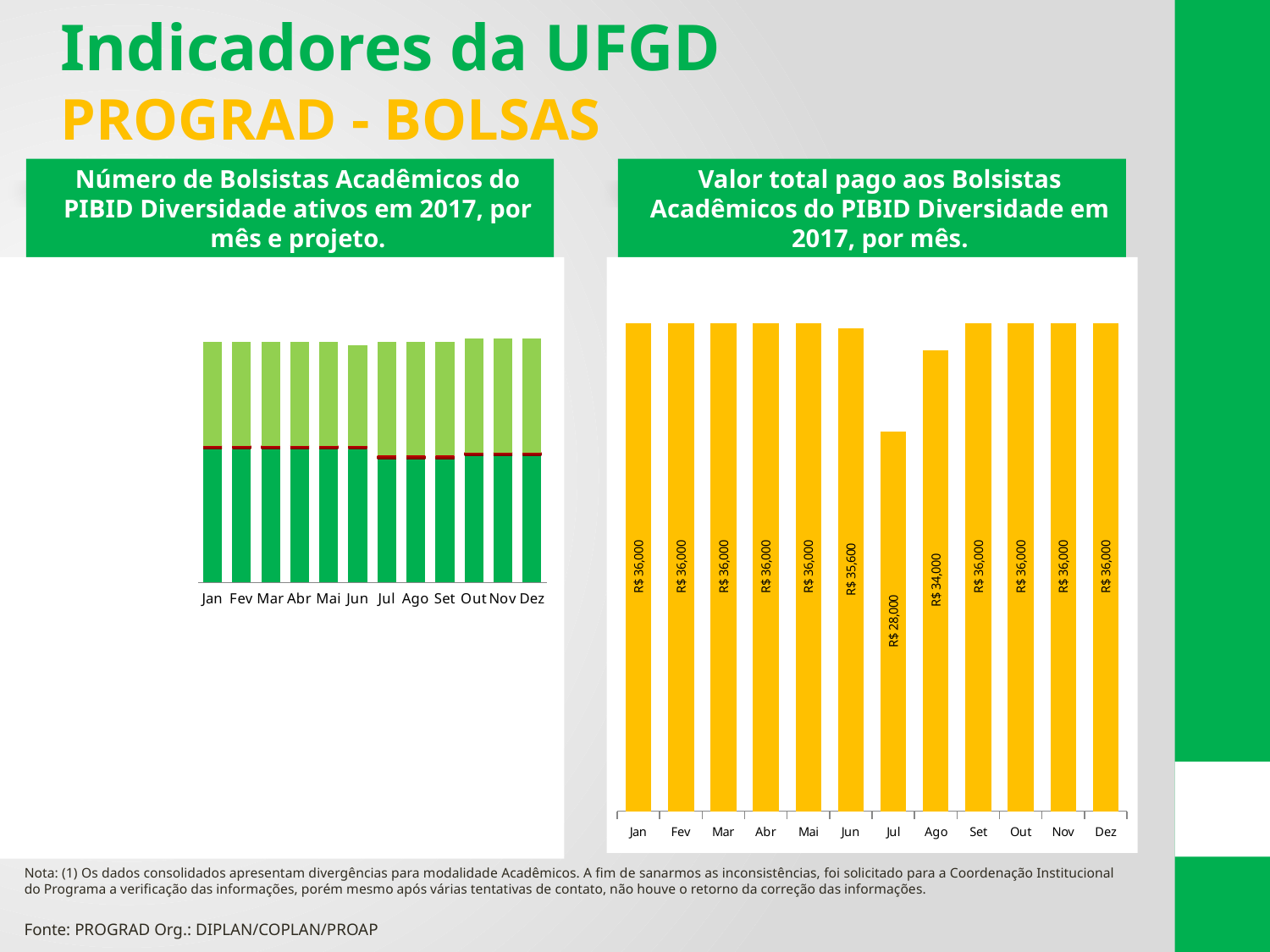
In the chart titled "Valor total pago aos Bolsistas Acadêmicos do PIBID Diversidade em 2017, por mês", what is the value for Jun? R$ 35,600 What kind of chart is the one on the right of the slide, titled "Valor total pago aos Bolsistas Acadêmicos do PIBID Diversidade em 2017, por mês"? Bar chart In the chart titled "Valor total pago aos Bolsistas Acadêmicos do PIBID Diversidade em 2017, por mês", what is the value for Ago? R$ 34,000 In the chart titled "Valor total pago aos Bolsistas Acadêmicos do PIBID Diversidade em 2017, por mês", what is the difference between the values for Ago and Jul? R$ 6,000 In the chart titled "Valor total pago aos Bolsistas Acadêmicos do PIBID Diversidade em 2017, por mês", which month has the lowest value? Jul In the chart titled "Valor total pago aos Bolsistas Acadêmicos do PIBID Diversidade em 2017, por mês", what is the difference between the values for Jan and Jul? R$ 8,000 In the chart titled "Valor total pago aos Bolsistas Acadêmicos do PIBID Diversidade em 2017, por mês", what is the value for Jul? R$ 28,000 In the chart titled "Valor total pago aos Bolsistas Acadêmicos do PIBID Diversidade em 2017, por mês", how many months have a value of R$ 36,000? 9 In the chart titled "Valor total pago aos Bolsistas Acadêmicos do PIBID Diversidade em 2017, por mês", how many months are shown on the x axis? 12 In the chart on the left of the slide, titled "Número de Bolsistas Acadêmicos do PIBID Diversidade ativos em 2017, por mês e projeto", how many months are shown on the x axis? 12 In the chart titled "Valor total pago aos Bolsistas Acadêmicos do PIBID Diversidade em 2017, por mês", what is the difference between the values for Mai and Jun? R$ 400 In the chart titled "Valor total pago aos Bolsistas Acadêmicos do PIBID Diversidade em 2017, por mês", which is larger, the value for Jun or the value for Ago? Jun